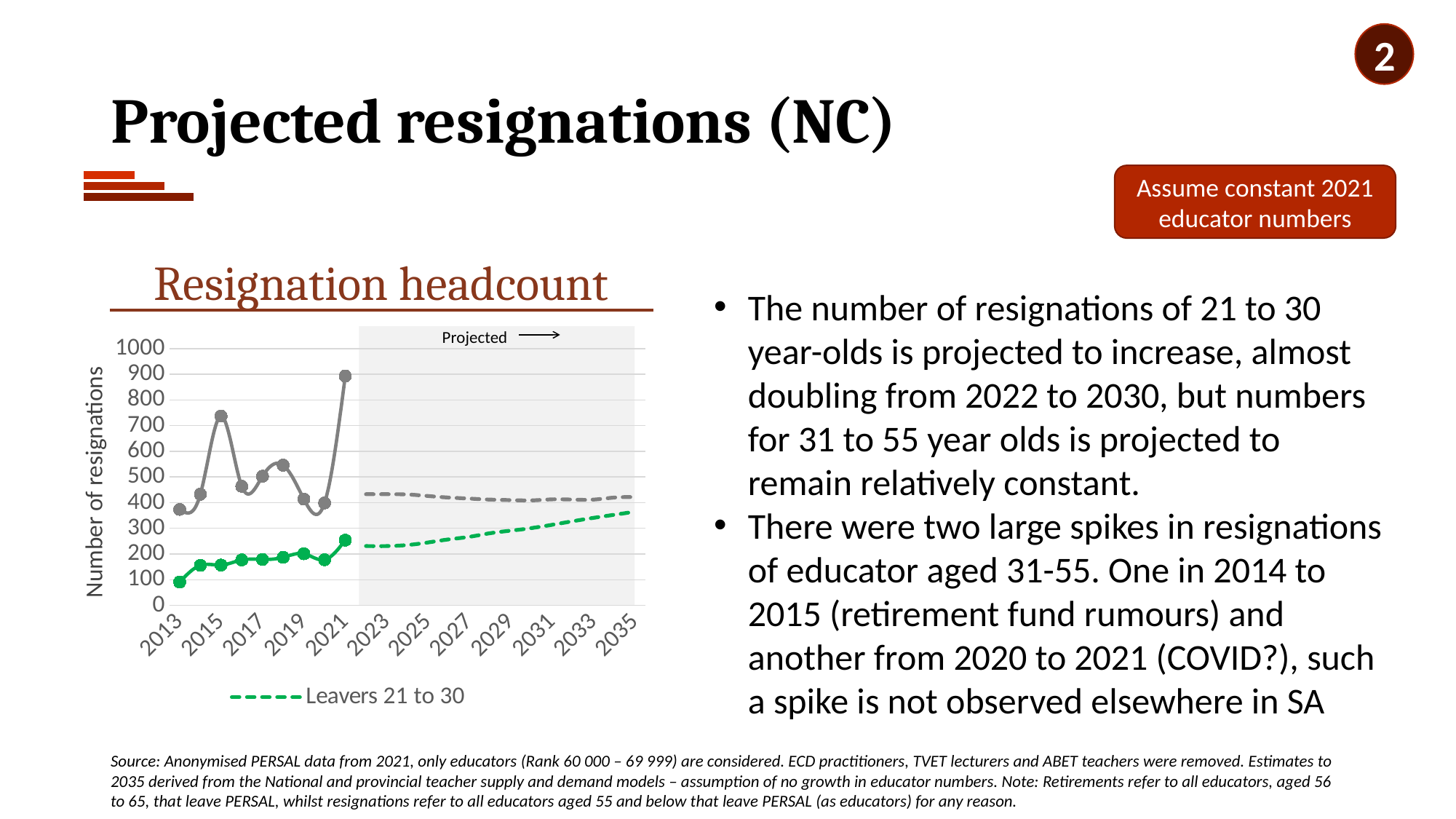
Which series name is listed in the chart's legend? Leavers 21 to 30 Is the projected value for Leavers 21 to 30 in 2035 greater or less than 300? greater Is the value of the grey line in 2013 greater or less than 400? less What kind of chart is shown under the title "Resignation headcount"? line chart Is the value of the grey line in 2015 greater or less than 700? greater What is the title of the chart on the slide? Resignation headcount Does the projected Leavers 21 to 30 line rise or fall from 2022 to 2035? rise In 2021, which line has the higher value, the grey line or the Leavers 21 to 30 line? the grey line What is the label on the vertical axis of the chart? Number of resignations